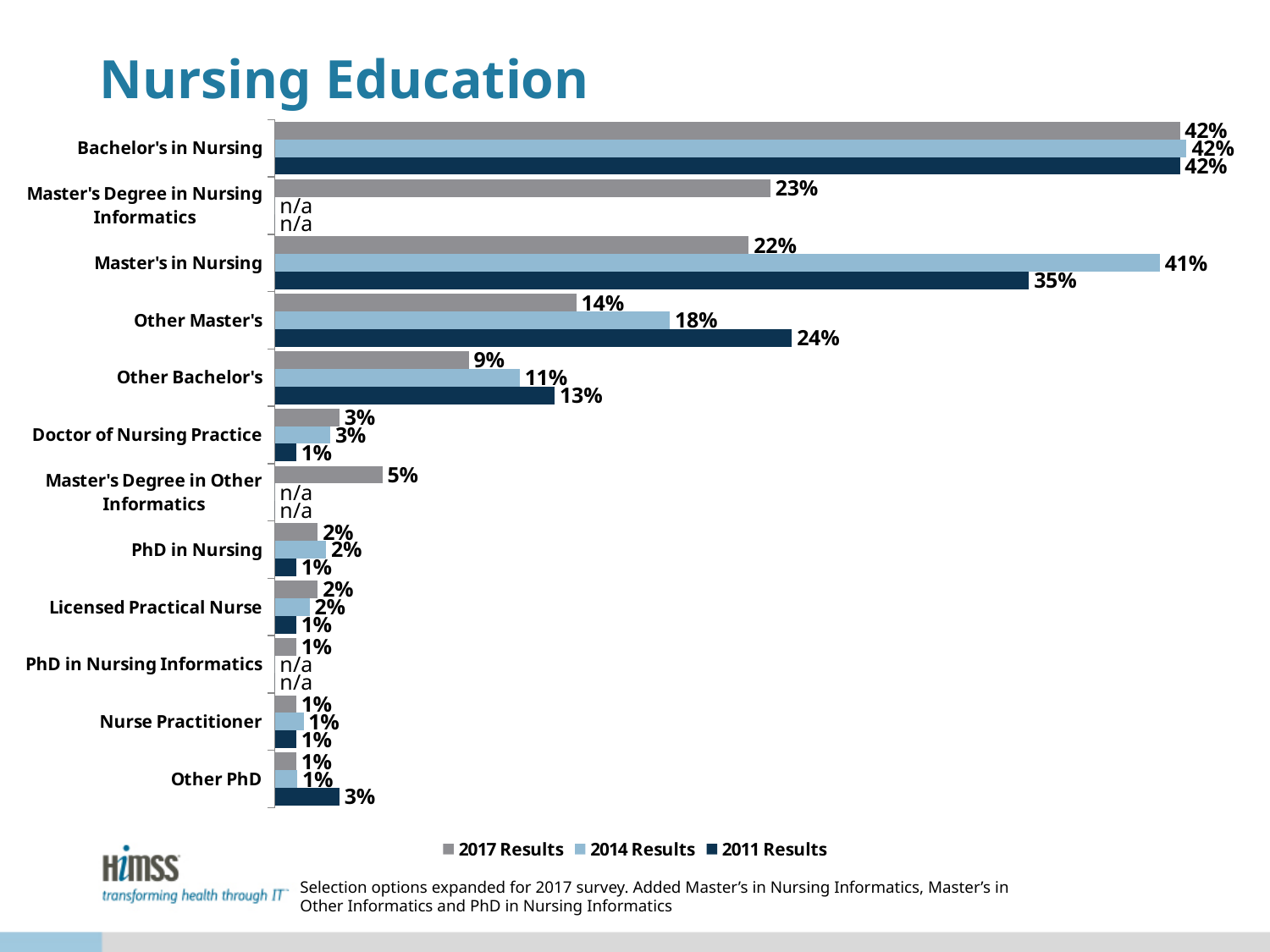
What is the title of the chart? Nursing Education What is the 2011 Results value for Other Master's? 24% What is the 2014 Results value for Master's in Nursing? 41% What is the difference between the 2014 Results and 2011 Results values for Master's in Nursing? 6% How many categories are shown on the chart? 12 What is the 2017 Results value for Master's Degree in Nursing Informatics? 23% How many series does the legend list? 3 What is the 2017 Results value for Master's in Nursing? 22% Which category has the highest 2017 Results value? Bachelor's in Nursing What kind of chart is shown on the slide? Bar chart Which is larger for Other Master's: the 2014 Results value or the 2011 Results value? 2011 Results What is the difference between the 2011 Results and 2017 Results values for Other Bachelor's? 4%